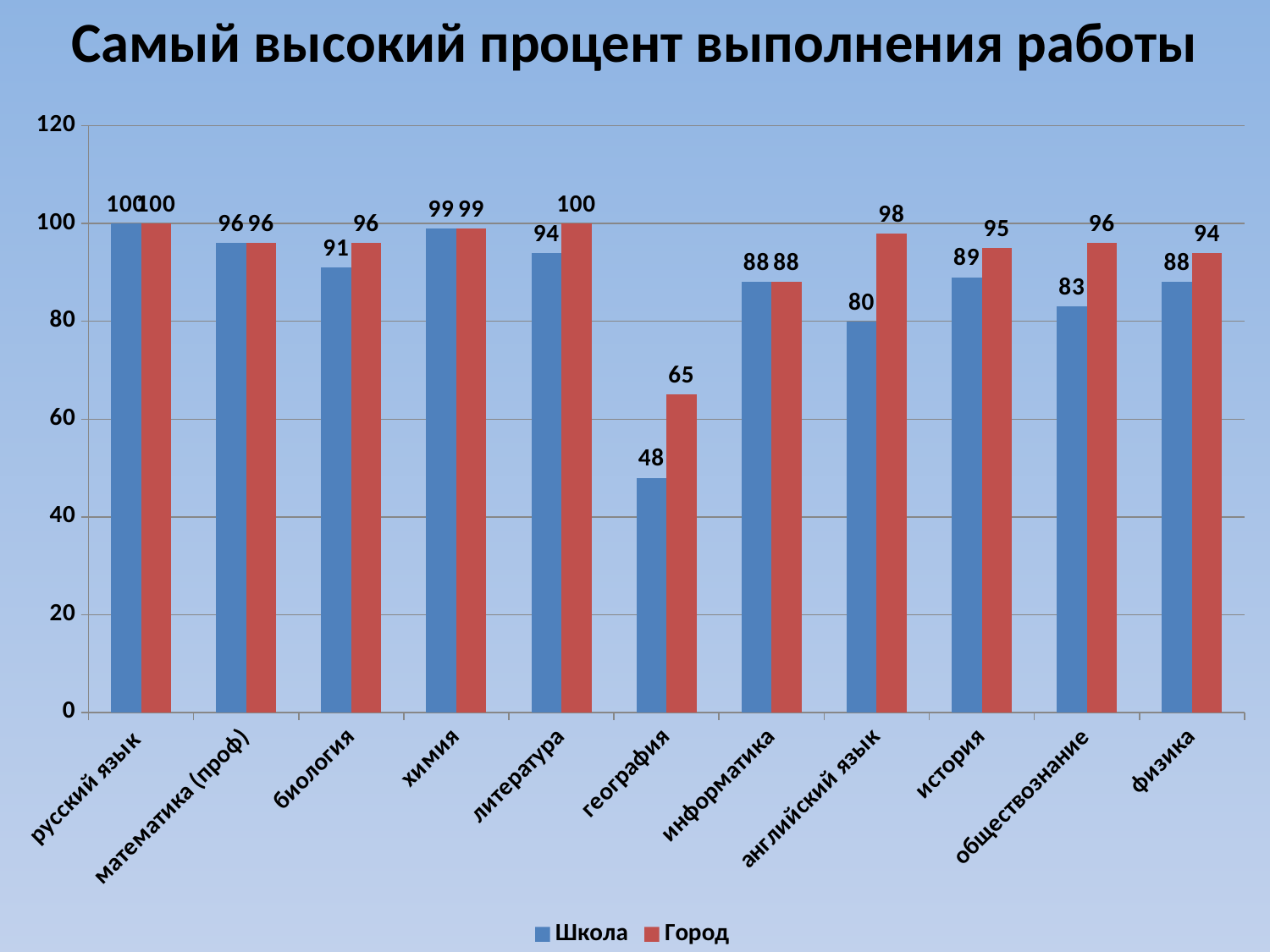
What is the difference between Город and Школа for английский язык? 18 What is the value for Школа for обществознание? 83 What kind of chart is shown on the slide? bar chart Which category has the lowest value for Школа? география What is the difference between Город and Школа for география? 17 How many categories are shown on the x axis? 11 What is the value for Школа for география? 48 What is the title of the chart? Самый высокий процент выполнения работы How many series does the legend list? 2 Which is larger for история: Школа or Город? Город Which category has the lowest value for Город? география What is the value for Город for английский язык? 98